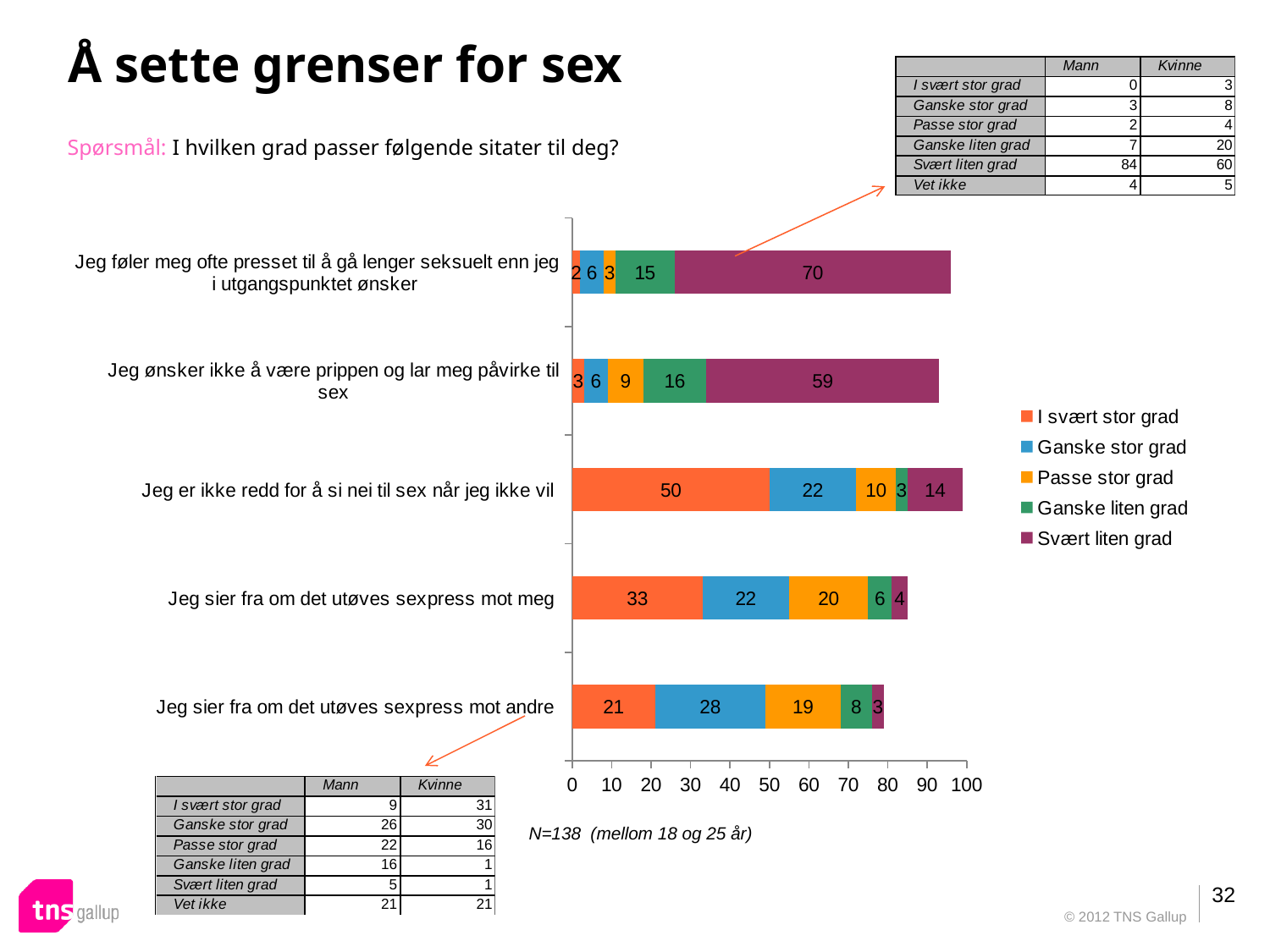
What is the value of 'I svært stor grad' for 'Jeg er ikke redd for å si nei til sex når jeg ikke vil'? 50 What is the total of the stacked bar for 'Jeg sier fra om det utøves sexpress mot andre'? 79 How many statements (categories) are plotted in the chart? 5 What is the value of 'Passe stor grad' for 'Jeg sier fra om det utøves sexpress mot meg'? 20 What is the difference between the 'Svært liten grad' values for 'Jeg føler meg ofte presset til å gå lenger seksuelt enn jeg i utgangspunktet ønsker' and 'Jeg ønsker ikke å være prippen og lar meg påvirke til sex'? 11 What is the value of 'Ganske stor grad' for 'Jeg sier fra om det utøves sexpress mot andre'? 28 Which statement has the highest value for 'Svært liten grad'? Jeg føler meg ofte presset til å gå lenger seksuelt enn jeg i utgangspunktet ønsker What is the value of 'Svært liten grad' for 'Jeg føler meg ofte presset til å gå lenger seksuelt enn jeg i utgangspunktet ønsker'? 70 Which is larger: 'I svært stor grad' for 'Jeg sier fra om det utøves sexpress mot meg' or for 'Jeg sier fra om det utøves sexpress mot andre'? Jeg sier fra om det utøves sexpress mot meg How many series does the legend list? 5 What kind of chart is shown on the slide? stacked bar chart Which statement has the lowest value for 'I svært stor grad'? Jeg føler meg ofte presset til å gå lenger seksuelt enn jeg i utgangspunktet ønsker